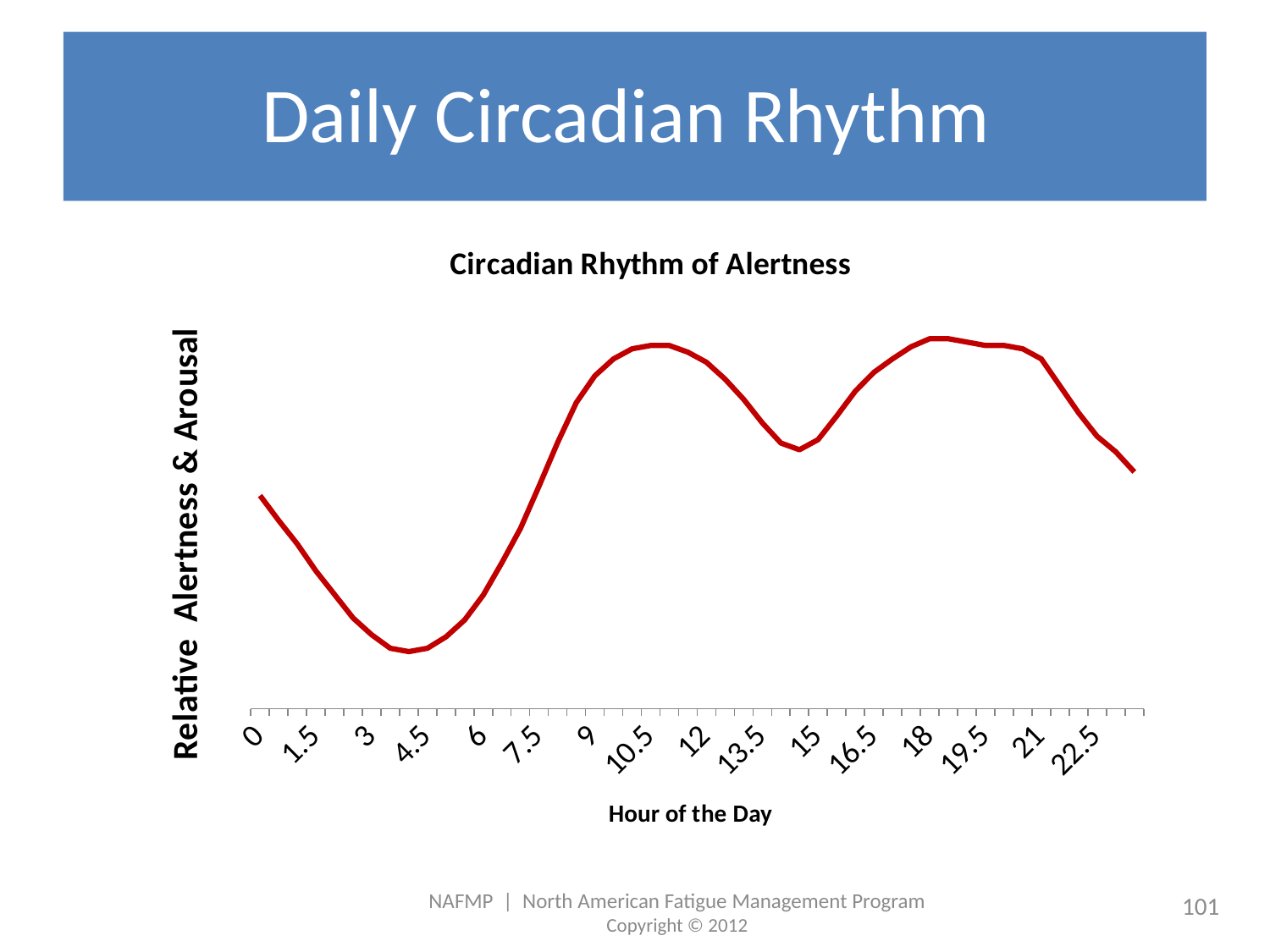
Is relative alertness higher at hour 0 or at hour 13.5? Hour 13.5 Does the line rise or fall between hour 15 and hour 18? Rise How many hour labels are shown along the x axis? 16 Is relative alertness higher at hour 9 or at hour 3? Hour 9 What is the label of the x axis? Hour of the Day What kind of chart is shown on the slide? Line chart Does the line rise or fall between hour 21 and the end of the day? Fall Does the line rise or fall between hour 0 and hour 4.5? Fall What is the title of the chart? Circadian Rhythm of Alertness